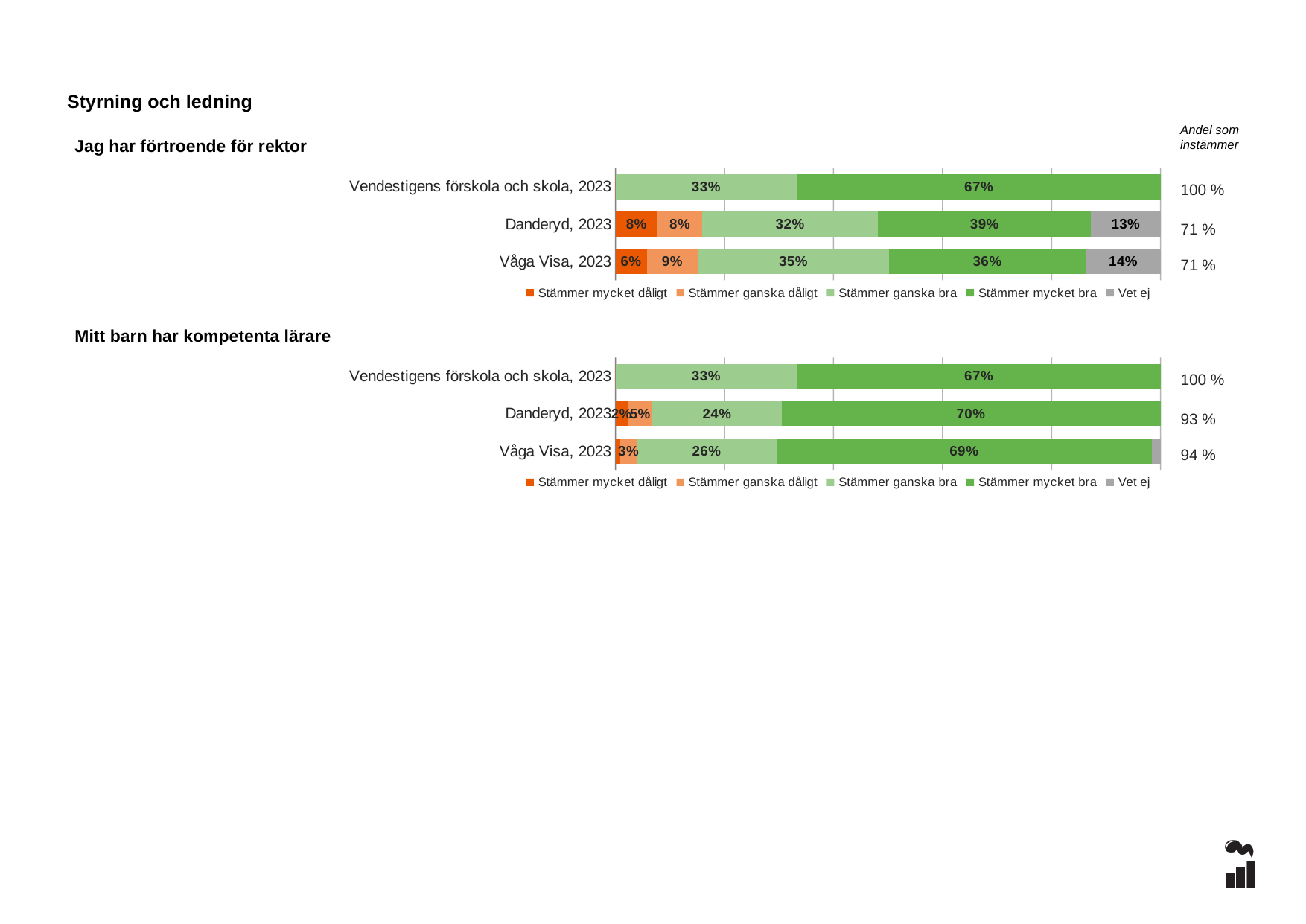
How many series does the legend of the chart 'Jag har förtroende för rektor' list? 5 In the chart 'Jag har förtroende för rektor', what is the 'Andel som instämmer' for Vendestigens förskola och skola, 2023? 100 % In the chart 'Jag har förtroende för rektor', what is the difference between the 'Stämmer mycket bra' values for Danderyd, 2023 and Våga Visa, 2023? 3 percentage points In the chart 'Jag har förtroende för rektor', what is the value of 'Vet ej' for Våga Visa, 2023? 14% In the chart 'Mitt barn har kompetenta lärare', what is the 'Andel som instämmer' for Danderyd, 2023? 93 % In the chart 'Jag har förtroende för rektor', which category has the highest 'Stämmer ganska bra' value? Våga Visa, 2023 In the chart 'Mitt barn har kompetenta lärare', what is the value of 'Stämmer mycket bra' for Danderyd, 2023? 70% In the chart 'Jag har förtroende för rektor', what is the value of 'Stämmer mycket bra' for Danderyd, 2023? 39% What kind of chart is 'Jag har förtroende för rektor'? Stacked bar chart In the chart 'Mitt barn har kompetenta lärare', what is the value of 'Stämmer ganska bra' for Våga Visa, 2023? 26% How many categories are shown in the chart 'Mitt barn har kompetenta lärare'? 3 In the chart 'Mitt barn har kompetenta lärare', which is larger: the 'Stämmer mycket bra' value for Danderyd, 2023 or for Våga Visa, 2023? Danderyd, 2023